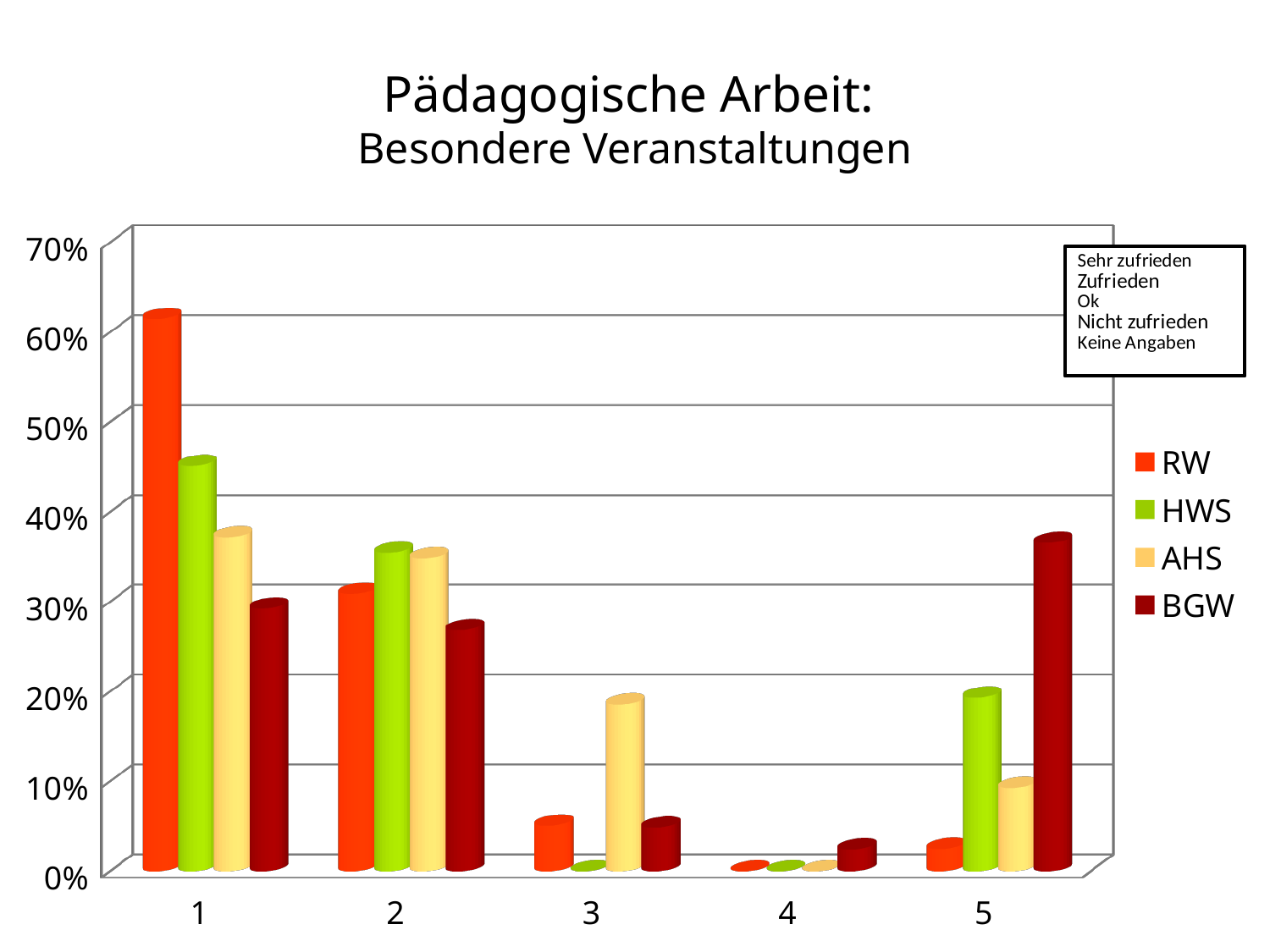
Which series has the highest value in category 1? RW Which is larger in category 5: the value for HWS or the value for AHS? HWS Which series has the highest value in category 5? BGW What is the title of the chart? Pädagogische Arbeit: Besondere Veranstaltungen What kind of chart is shown on the slide? bar chart Which series has the lowest value in category 1? BGW Is the value for AHS in category 3 greater or less than 10%? greater Is the value for RW in category 1 greater or less than 60%? greater How many categories are shown on the x axis? 5 Which is larger in category 1: the value for HWS or the value for AHS? HWS How many series does the legend list? 4